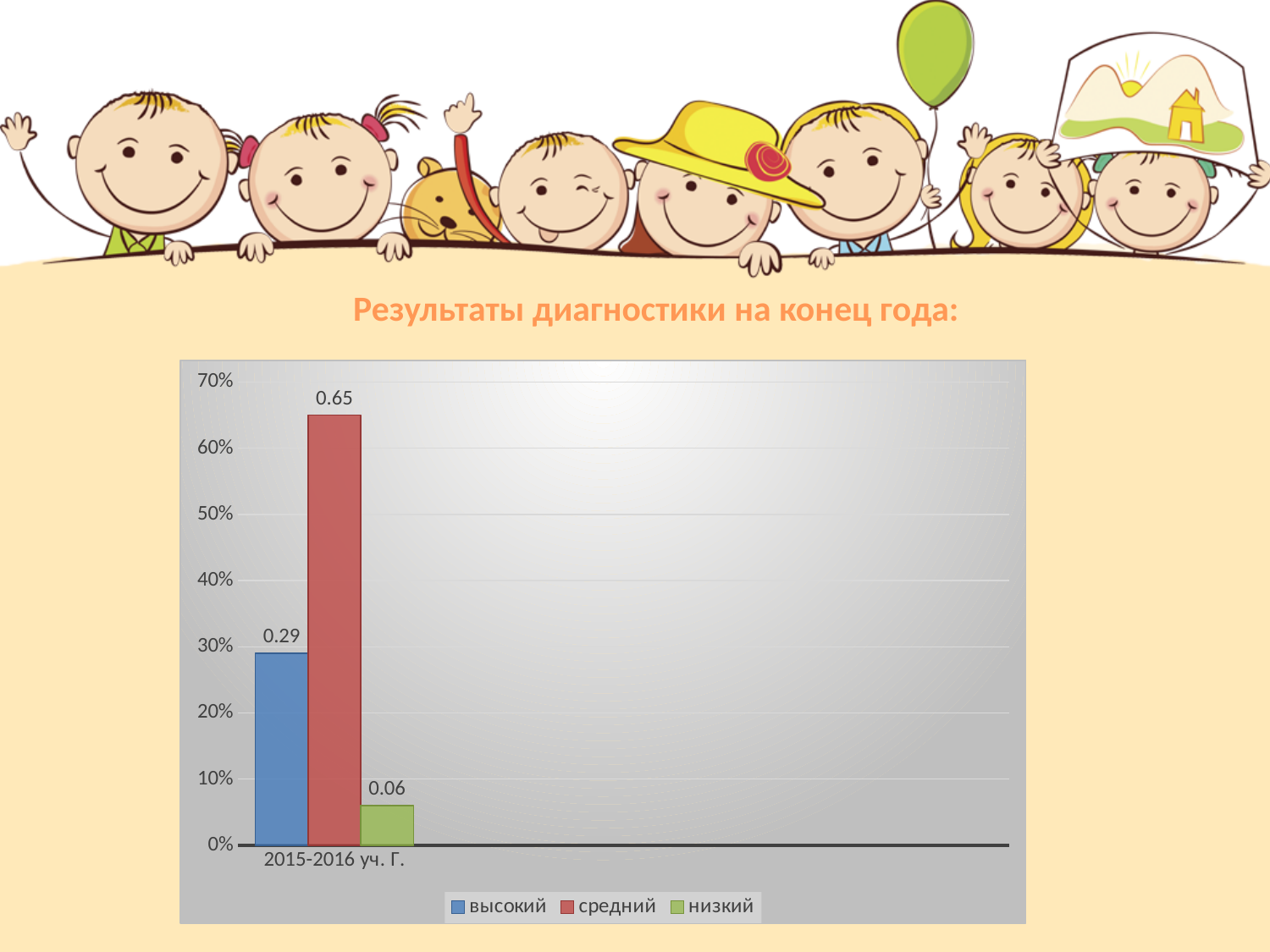
Which is larger, the 'высокий' value or the 'низкий' value? высокий How many categories are shown on the x axis? 1 What is the difference between the 'средний' and 'высокий' values? 0.36 Which series has the highest value? средний What is the title above the chart? Результаты диагностики на конец года: What is the value of the 'низкий' series for 2015-2016 уч. Г.? 0.06 What is the value of the 'средний' series for 2015-2016 уч. Г.? 0.65 What kind of chart is shown on the slide? bar chart What is the value of the 'высокий' series for 2015-2016 уч. Г.? 0.29 Which series has the lowest value? низкий How many series does the legend list? 3 Is the value for 'средний' greater or less than 60%? greater